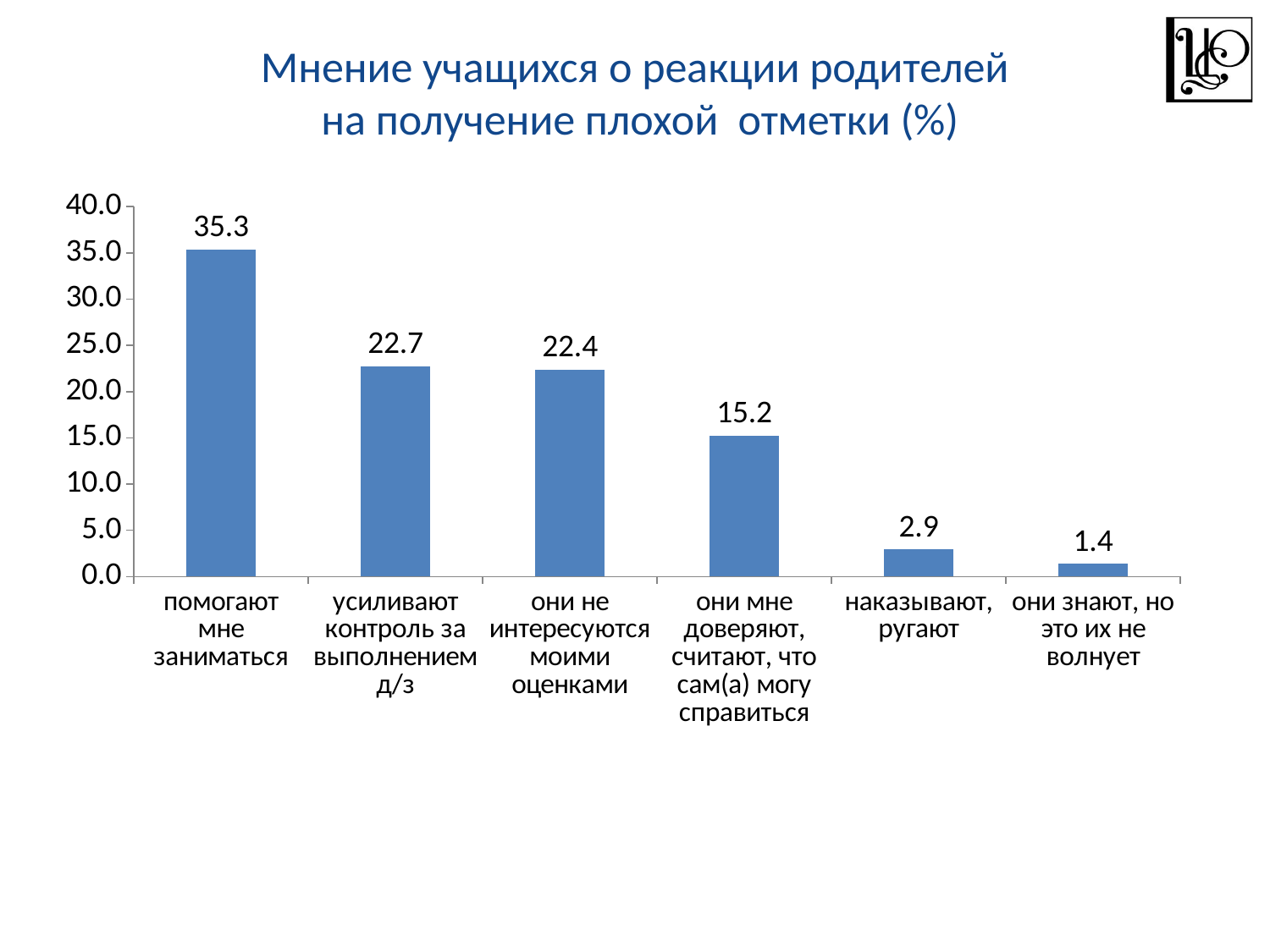
What is the value for "они мне доверяют, считают, что сам(а) могу справиться"? 15.2 What kind of chart is shown on the slide? bar chart Which is larger: the value for "они мне доверяют, считают, что сам(а) могу справиться" or the value for "наказывают, ругают"? они мне доверяют, считают, что сам(а) могу справиться Which category has the highest value? помогают мне заниматься What is the value for "наказывают, ругают"? 2.9 What is the difference between the values for "наказывают, ругают" and "они знают, но это их не волнует"? 1.5 Which category has the lowest value? они знают, но это их не волнует Do the values rise or fall from left to right along the x axis? fall What is the difference between the values for "помогают мне заниматься" and "усиливают контроль за выполнением д/з"? 12.6 What is the value for "помогают мне заниматься"? 35.3 How many categories are shown in the chart? 6 Is the value for "они не интересуются моими оценками" greater or less than 20.0? greater